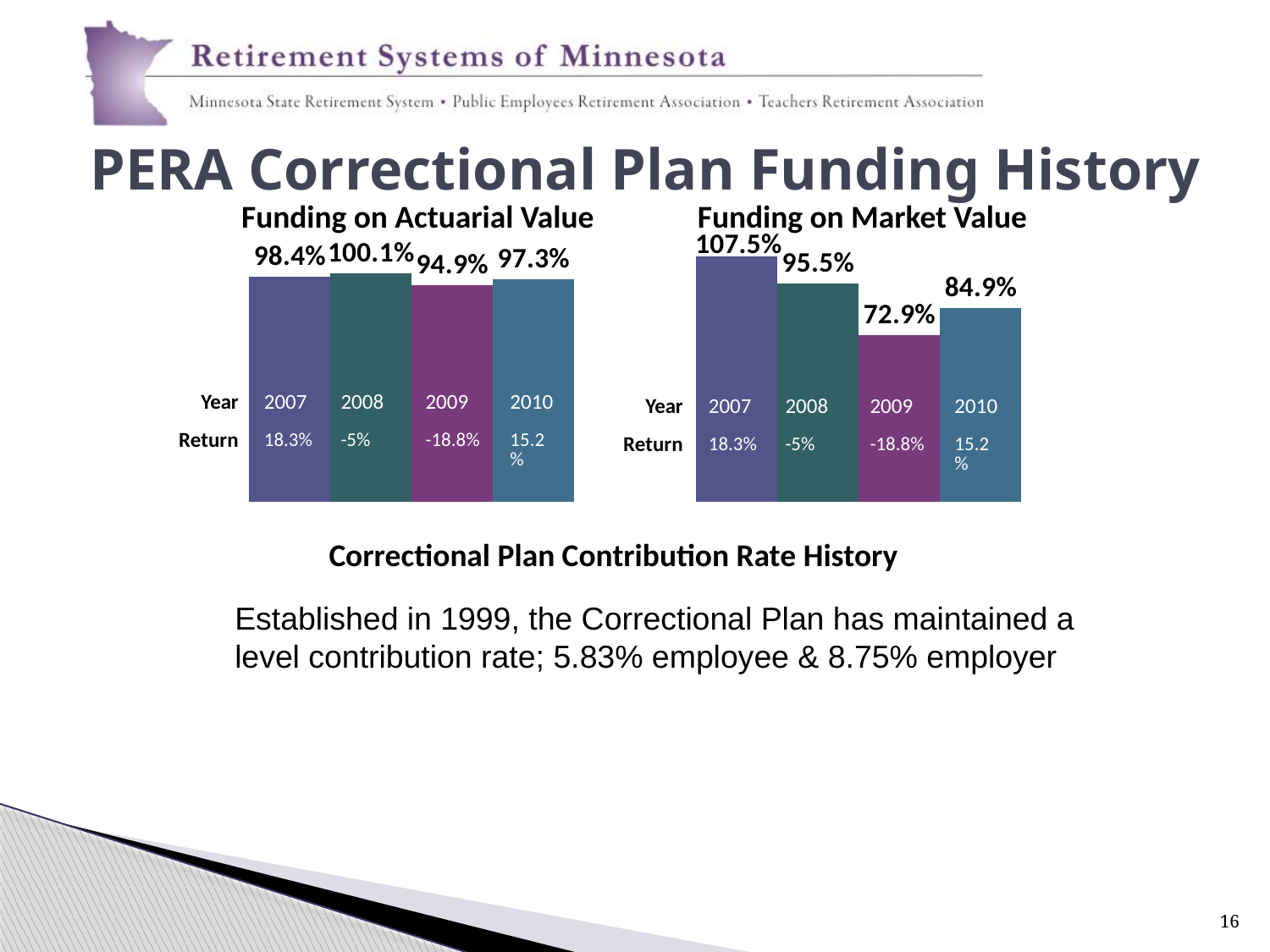
In the Funding on Actuarial Value chart, which year has the lowest value? 2009 In the Funding on Actuarial Value chart, which year has the highest value? 2008 In the Funding on Market Value chart, which year has the highest value? 2007 What kind of chart is the Funding on Actuarial Value chart? Bar chart In the Funding on Actuarial Value chart, what is the value for 2008? 100.1% In the Funding on Market Value chart, what is the difference between the 2007 and 2009 values? 34.6 percentage points How many years are shown in the Funding on Market Value chart? 4 In the Funding on Market Value chart, what is the value for 2009? 72.9% In the Funding on Actuarial Value chart, which is larger, the value for 2007 or the value for 2010? 2007 In the Funding on Market Value chart, do the values rise or fall from 2007 to 2009? Fall In the Funding on Market Value chart, which year has the lowest value? 2009 In the Funding on Market Value chart, what is the value for 2010? 84.9%